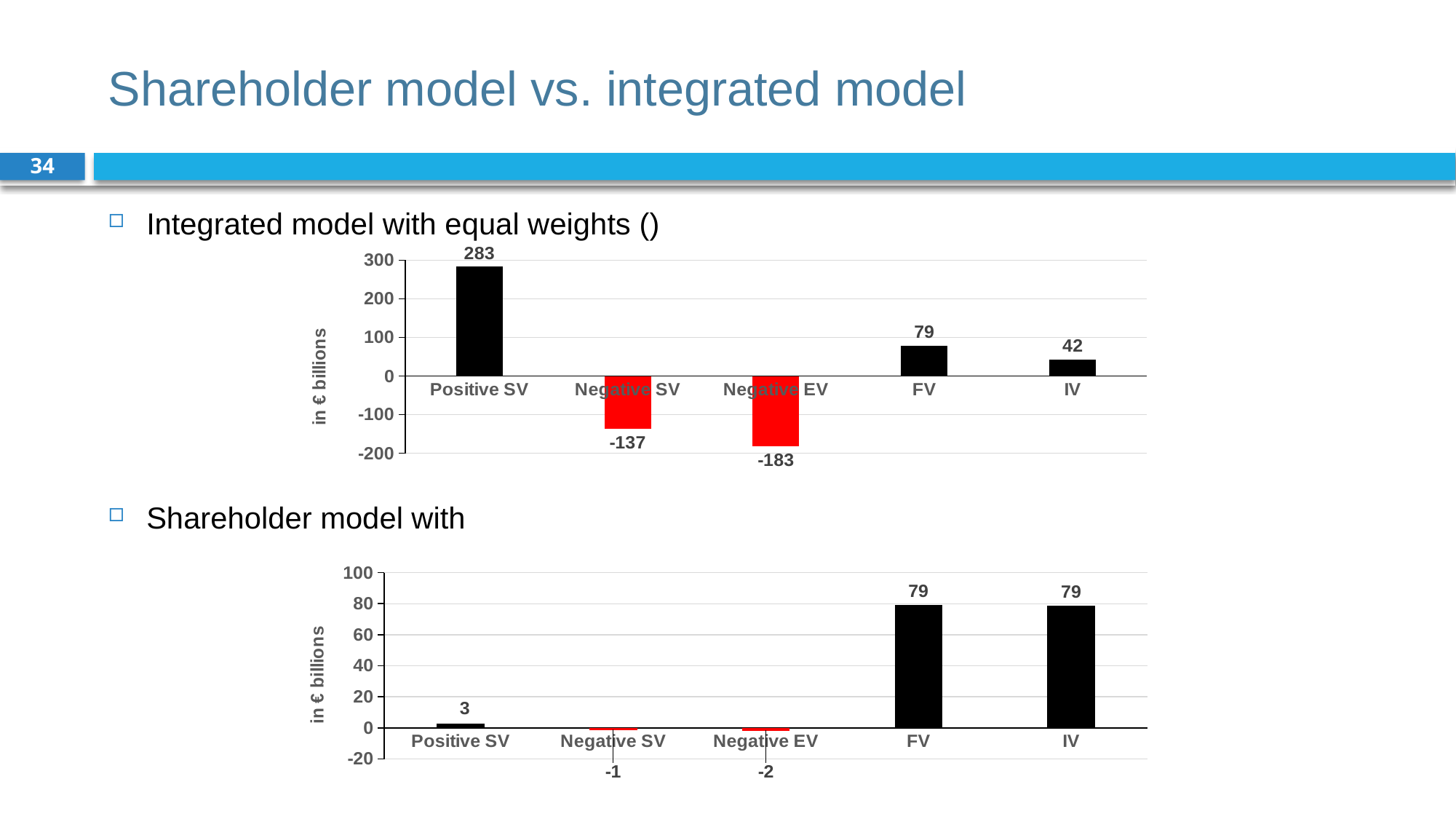
What is the y-axis label of the top chart (Integrated model with equal weights)? in € billions What kind of chart is the bottom chart (Shareholder model)? Bar chart In the bottom chart (Shareholder model), which category has the lowest value? Negative EV In the top chart (Integrated model with equal weights), what is the difference between the values for FV and IV? 37 In the bottom chart (Shareholder model), what is the value for Positive SV? 3 In the bottom chart (Shareholder model), what is the difference between the values for FV and Positive SV? 76 In the top chart (Integrated model with equal weights), what is the value for Negative EV? -183 In the top chart (Integrated model with equal weights), what is the value for Positive SV? 283 In the top chart (Integrated model with equal weights), which category has the lowest value? Negative EV In the top chart (Integrated model with equal weights), which is larger, the value for FV or the value for IV? FV In the bottom chart (Shareholder model), what is the value for Negative SV? -1 In the top chart (Integrated model with equal weights), how many categories are shown on the x axis? 5